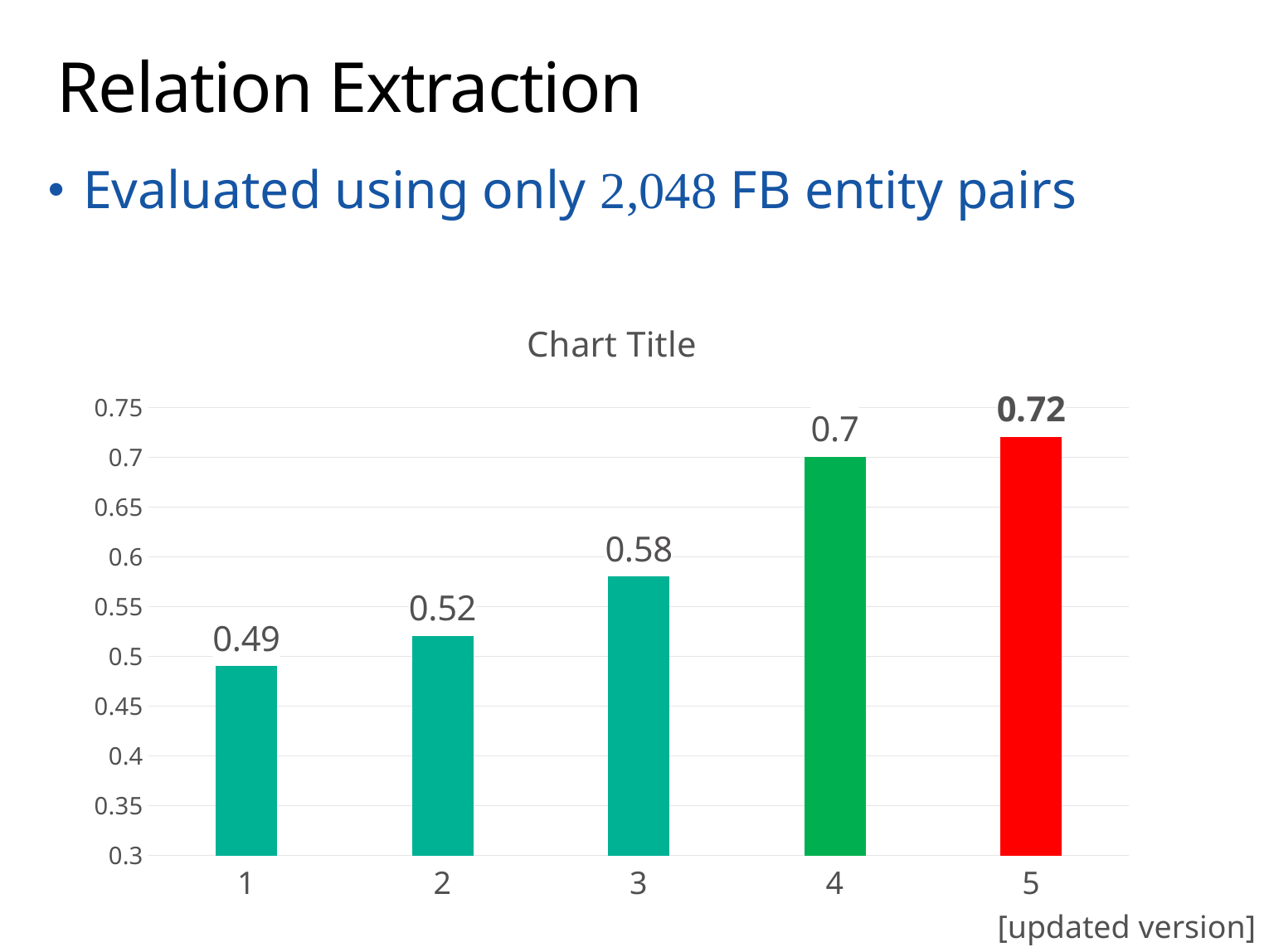
What is the difference between the values for category 5 and category 4? 0.02 Which category has the lowest value? 1 What is the difference between the values for category 3 and category 1? 0.09 Which is larger, the value for category 2 or the value for category 4? 4 What is the value for category 5? 0.72 How many bars are shown in the chart? 5 What is the value for category 1? 0.49 Do the values rise or fall from category 1 to category 5? rise Which category has the highest value? 5 What is the value for category 3? 0.58 Is the value for category 2 greater or less than 0.55? less What kind of chart is shown on the slide? bar chart